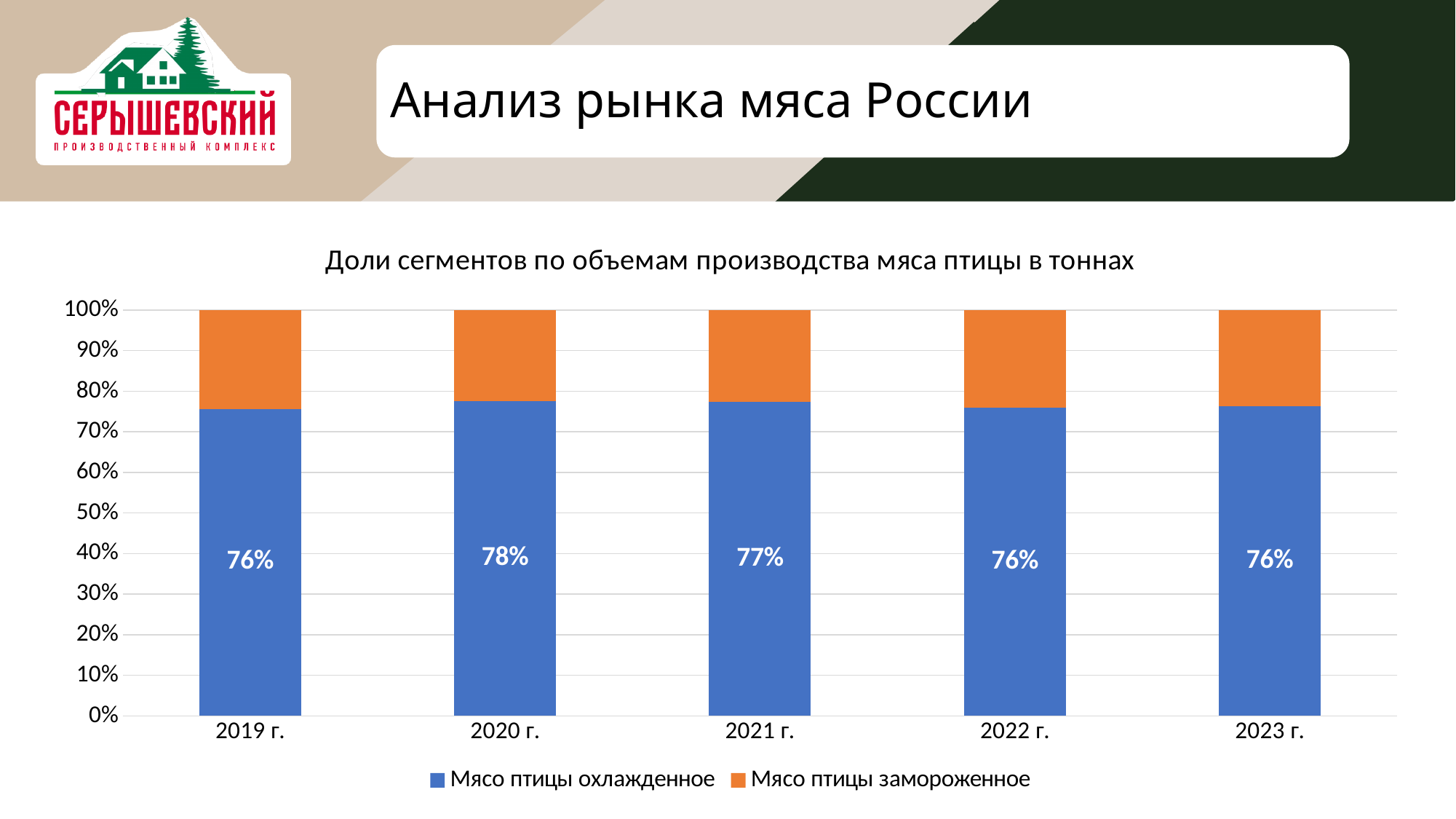
What kind of chart is shown on the slide? Stacked bar chart What is the value for Мясо птицы охлажденное in 2019 г.? 76% What is the value for Мясо птицы охлажденное in 2021 г.? 77% How many series does the chart legend list? 2 What is the title of the chart? Доли сегментов по объемам производства мяса птицы в тоннах What is the difference between the Мясо птицы охлажденное share in 2020 г. and in 2019 г.? 2% Which year has a larger share of Мясо птицы охлажденное, 2020 г. or 2021 г.? 2020 г. What is the value for Мясо птицы охлажденное in 2023 г.? 76% What is the value for Мясо птицы охлажденное in 2020 г.? 78% How many years are shown on the x axis of the chart? 5 In which year is the share of Мясо птицы охлажденное the highest? 2020 г. Is the value for Мясо птицы охлажденное in 2022 г. greater or less than 70%? greater